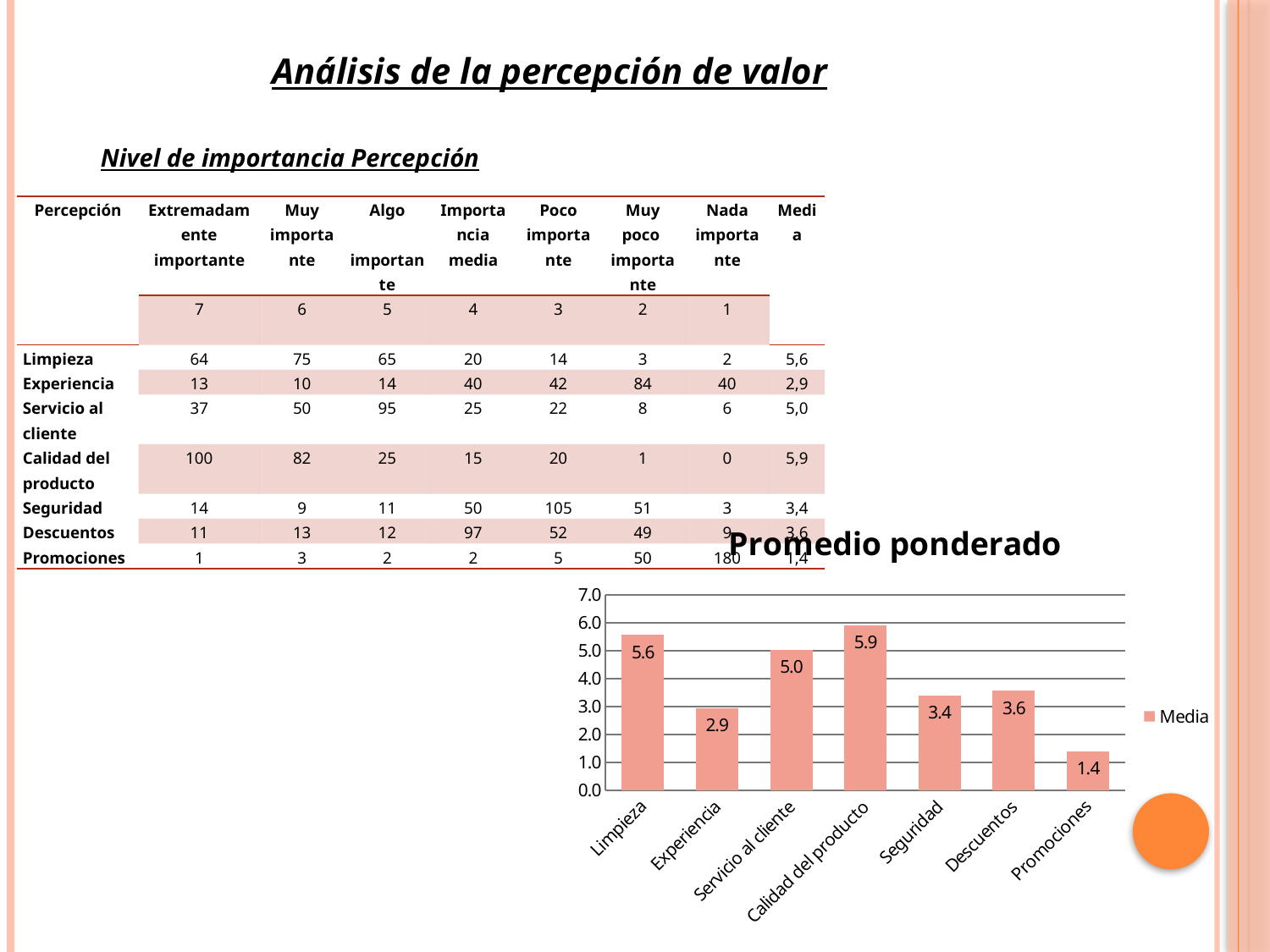
Which category has the highest value in the Promedio ponderado chart? Calidad del producto Is the value for Servicio al cliente in the Promedio ponderado chart greater or less than 4.0? greater Which category has the lowest value in the Promedio ponderado chart? Promociones What is the value for Experiencia in the Promedio ponderado chart? 2.9 What is the value for Limpieza in the Promedio ponderado chart? 5.6 What is the difference between the values for Calidad del producto and Promociones in the Promedio ponderado chart? 4.5 What is the name of the series shown in the legend of the Promedio ponderado chart? Media How many series does the legend of the Promedio ponderado chart list? 1 What is the value for Promociones in the Promedio ponderado chart? 1.4 Which is larger in the Promedio ponderado chart, Seguridad or Descuentos? Descuentos How many categories are shown in the Promedio ponderado chart? 7 What kind of chart is the Promedio ponderado chart? Bar chart